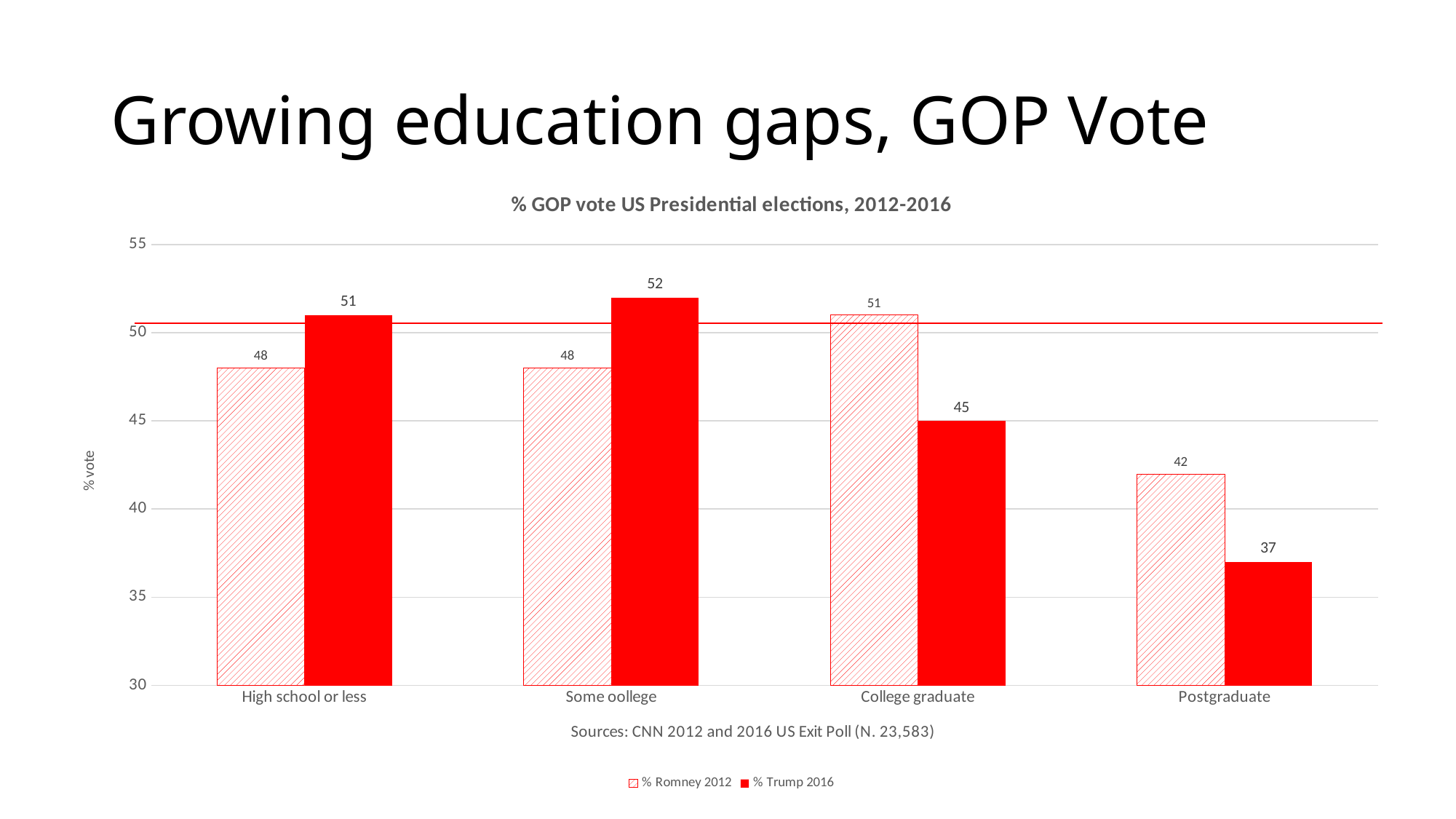
Which education category has the lowest % Romney 2012 value? Postgraduate How many education categories are shown on the x axis? 4 What is the % Trump 2016 value for Some college? 52 Is the % Trump 2016 value for High school or less greater or less than 50? greater How many series does the legend list? 2 What is the % Trump 2016 value for College graduate? 45 What is the title of the chart? % GOP vote US Presidential elections, 2012-2016 For College graduate, which is larger: % Romney 2012 or % Trump 2016? % Romney 2012 What is the difference between the % Romney 2012 and % Trump 2016 values for Postgraduate? 5 What kind of chart is shown on the slide? Bar chart Which education category has the highest % Trump 2016 value? Some college What is the % Romney 2012 value for Postgraduate? 42